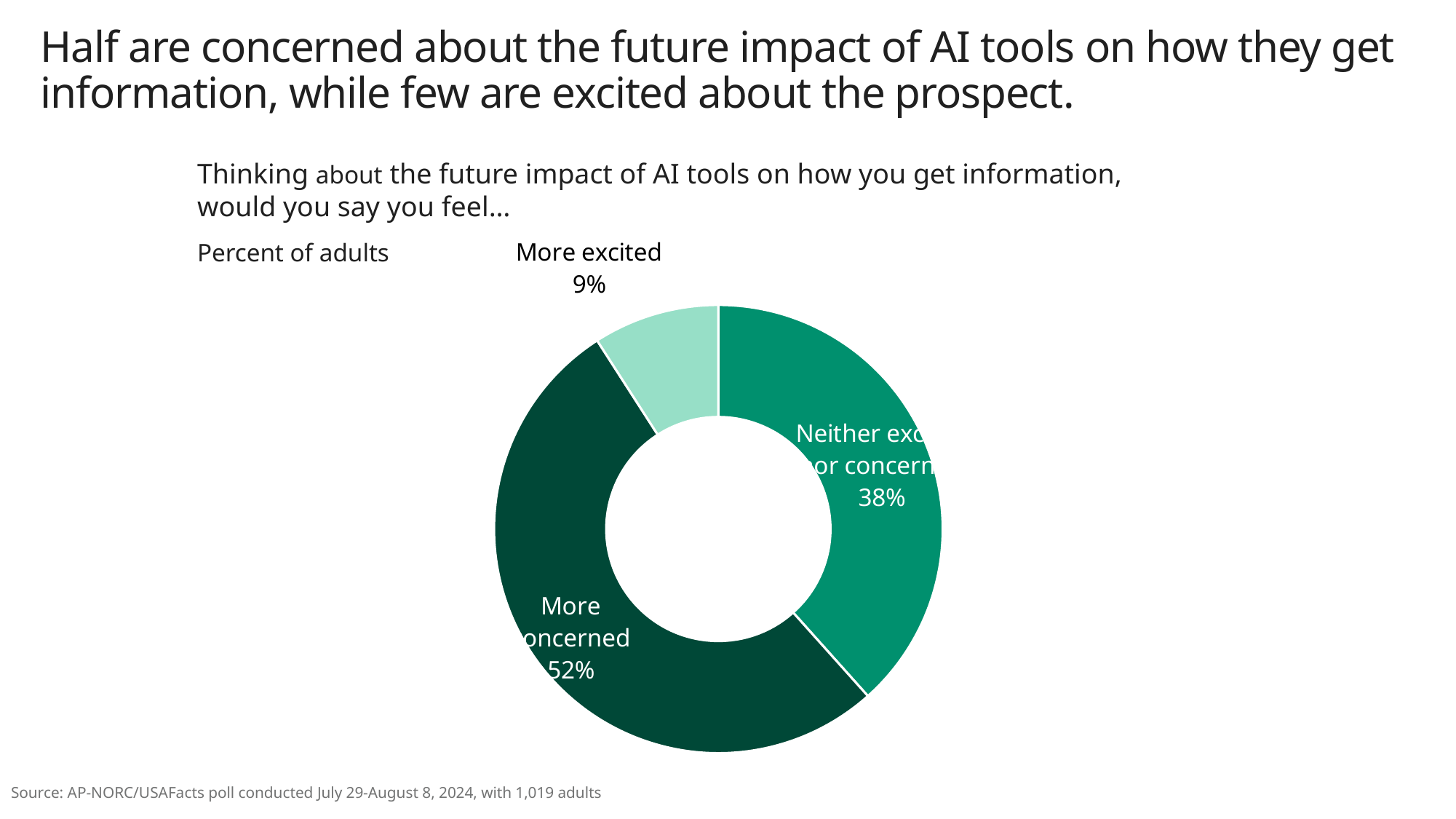
What percentage of adults say they feel neither excited nor concerned? 38% What kind of chart is shown on the slide? Donut (pie) chart Which response has the largest share of the donut chart? More concerned Which slice of the chart is shown in the lightest green colour? More excited Which response has the smallest share of the donut chart? More excited What percentage of adults say they feel more concerned about the future impact of AI tools on how they get information? 52% How many response categories are shown in the chart? 3 Which is larger: the share for 'Neither excited nor concerned' or the share for 'More excited'? Neither excited nor concerned What unit is the chart measured in, according to the label above the chart? Percent of adults What is the difference in percentage points between 'More concerned' and 'More excited'? 43 What is the difference in percentage points between 'More concerned' and 'Neither excited nor concerned'? 14 What percentage of adults say they feel more excited about the future impact of AI tools? 9%